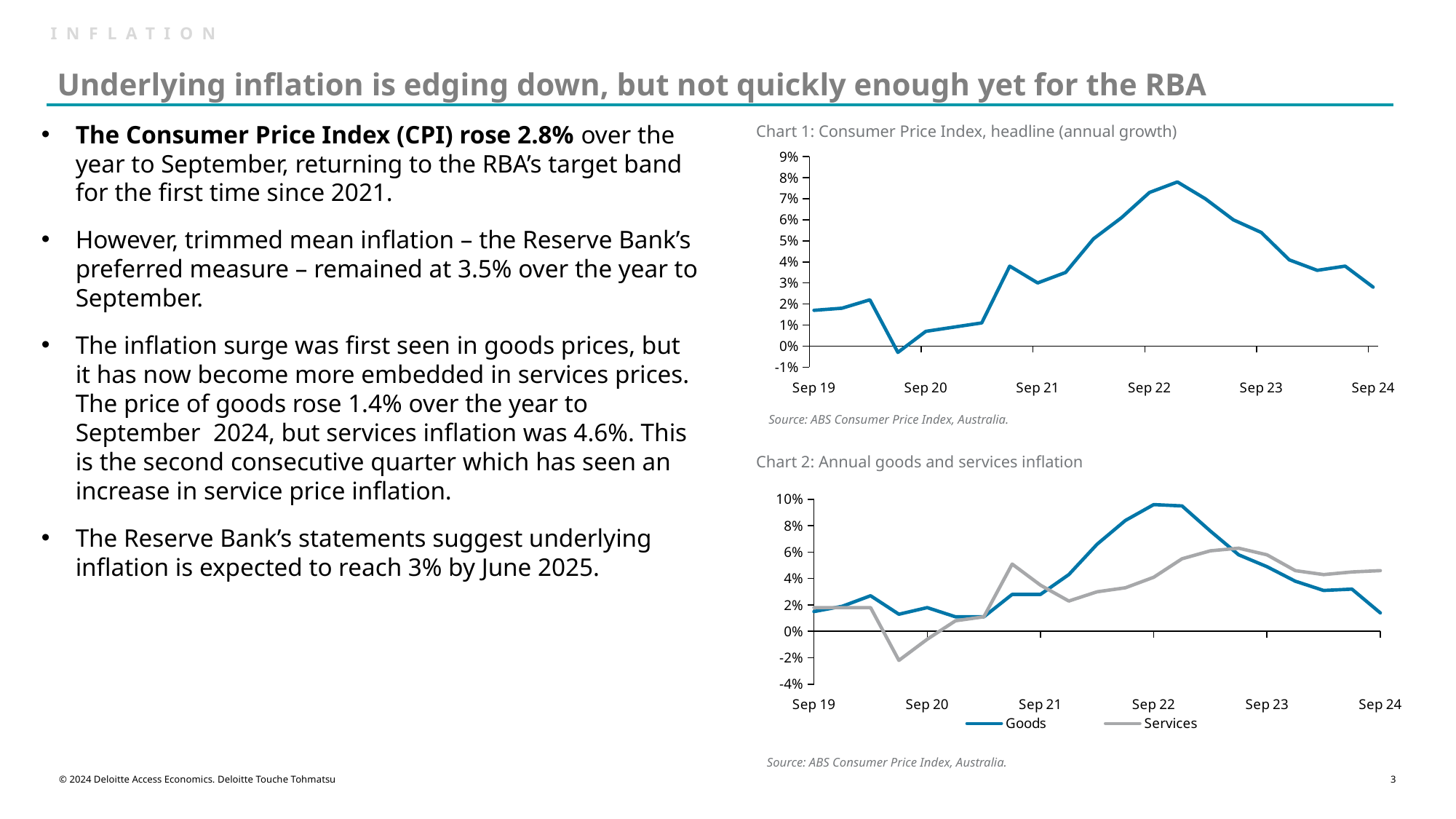
In Chart 2: Annual goods and services inflation, is the Goods value at Sep 24 greater or less than 2%? less In Chart 1: Consumer Price Index, headline (annual growth), is the value at Sep 22 greater or less than 5%? greater In Chart 1: Consumer Price Index, headline (annual growth), is the highest point of the line greater or less than 7%? greater How many series does the legend of Chart 2: Annual goods and services inflation list? 2 In Chart 1: Consumer Price Index, headline (annual growth), does the line rise or fall between Sep 22 and Sep 24? fall What kind of chart is Chart 1: Consumer Price Index, headline (annual growth)? line chart In Chart 2: Annual goods and services inflation, which series is higher at Sep 22, Goods or Services? Goods How many year labels are shown on the x axis of Chart 1: Consumer Price Index, headline (annual growth)? 6 What are the two series named in the legend of Chart 2: Annual goods and services inflation? Goods and Services In Chart 2: Annual goods and services inflation, which series is higher at Sep 24, Goods or Services? Services